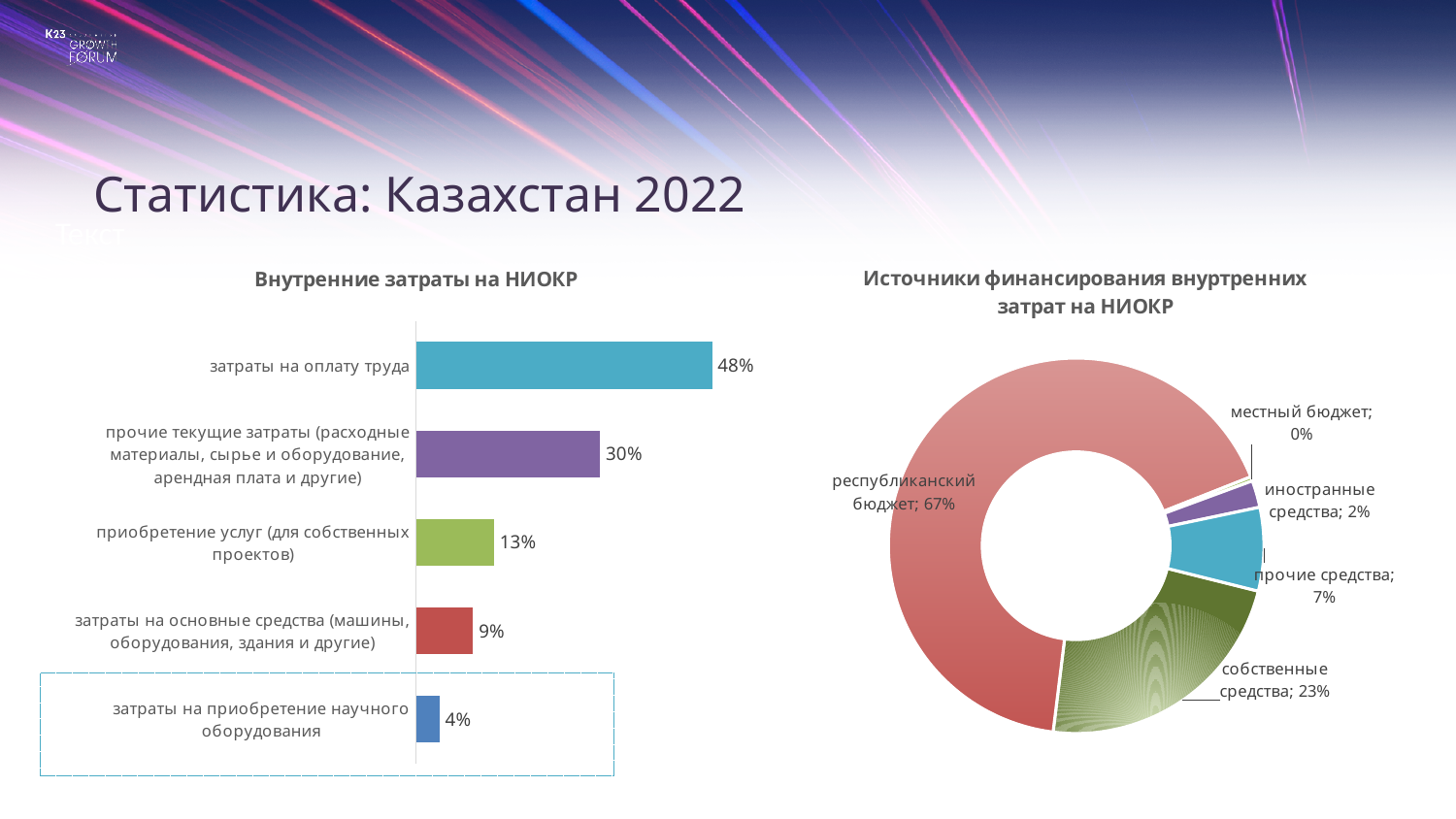
In the chart "Внутренние затраты на НИОКР", how many categories are shown? 5 In the chart "Внутренние затраты на НИОКР", which category has the highest value? затраты на оплату труда In the chart "Источники финансирования внутренних затрат на НИОКР", what is the value for "собственные средства"? 23% In the chart "Внутренние затраты на НИОКР", what is the value for "приобретение услуг (для собственных проектов)"? 13% In the chart "Источники финансирования внутренних затрат на НИОКР", how many slices are labelled? 5 In the chart "Внутренние затраты на НИОКР", which category has the lowest value? затраты на приобретение научного оборудования In the chart "Внутренние затраты на НИОКР", what is the difference between "затраты на оплату труда" and "прочие текущие затраты (расходные материалы, сырье и оборудование, арендная плата и другие)"? 18% In the chart "Источники финансирования внутренних затрат на НИОКР", what share does "республиканский бюджет" have? 67% What kind of chart is "Источники финансирования внутренних затрат на НИОКР"? doughnut chart In the chart "Источники финансирования внутренних затрат на НИОКР", which is larger: "прочие средства" or "иностранные средства"? прочие средства What kind of chart is "Внутренние затраты на НИОКР"? bar chart In the chart "Внутренние затраты на НИОКР", what is the value for "затраты на оплату труда"? 48%